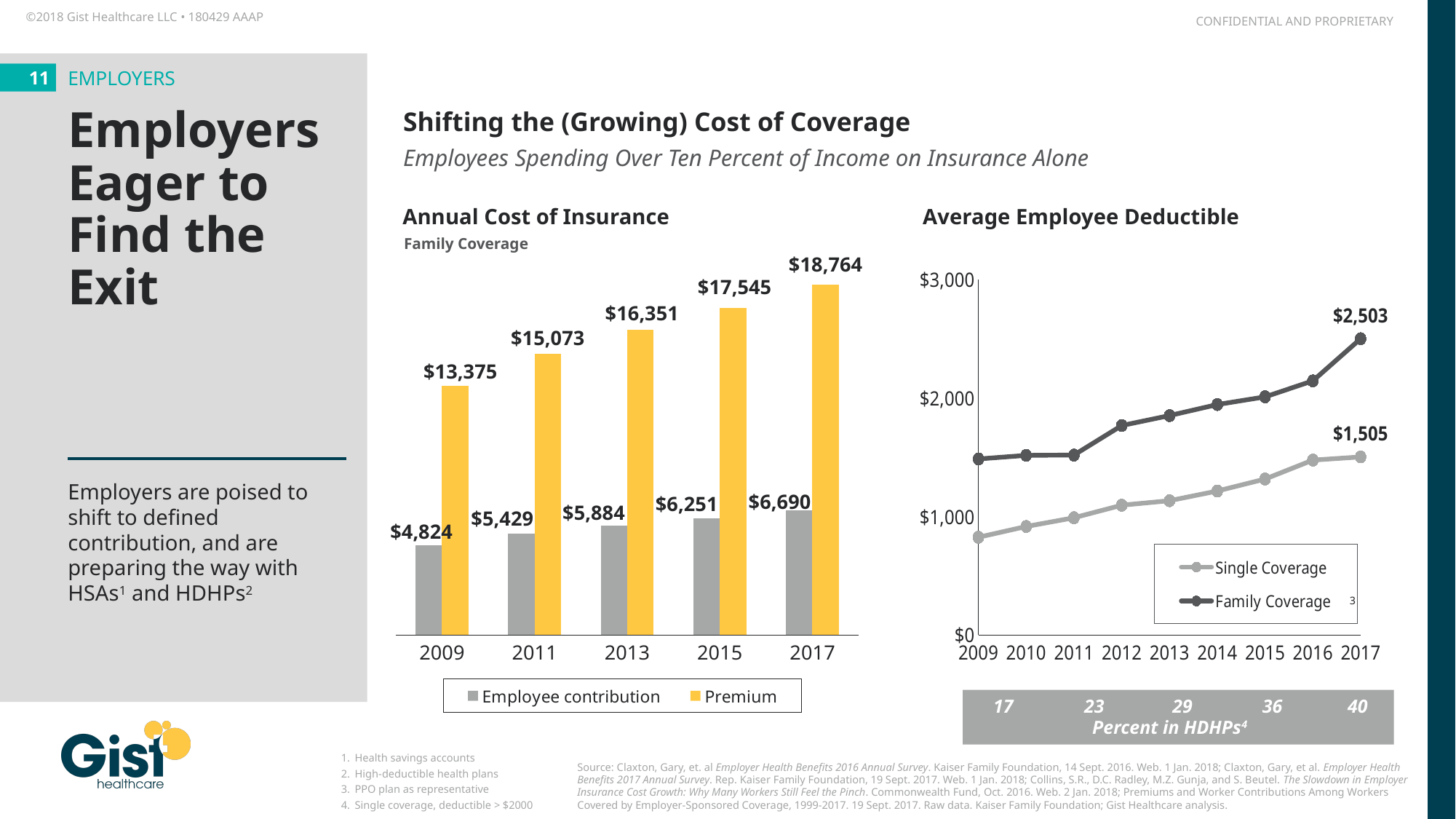
In the Annual Cost of Insurance chart, how many years are shown on the x axis? 5 In the Annual Cost of Insurance chart, what is the difference between the Premium in 2017 and the Premium in 2009? $5,389 In the Annual Cost of Insurance chart, which year has the highest Employee contribution? 2017 In the Average Employee Deductible chart, is the Single Coverage value in 2009 greater or less than $1,000? less In the Annual Cost of Insurance chart, how many series does the legend list? 2 In the Annual Cost of Insurance chart, which year has the lowest Premium? 2009 In the Average Employee Deductible chart, do the Family Coverage values rise or fall from 2009 to 2017? Rise In the Average Employee Deductible chart, what is the Family Coverage value in 2017? $2,503 In the Annual Cost of Insurance chart, what was the Premium in 2013? $16,351 In the Annual Cost of Insurance chart, what was the Premium in 2017? $18,764 In the Annual Cost of Insurance chart, what was the Employee contribution in 2009? $4,824 What kind of chart is the Annual Cost of Insurance chart? Bar chart